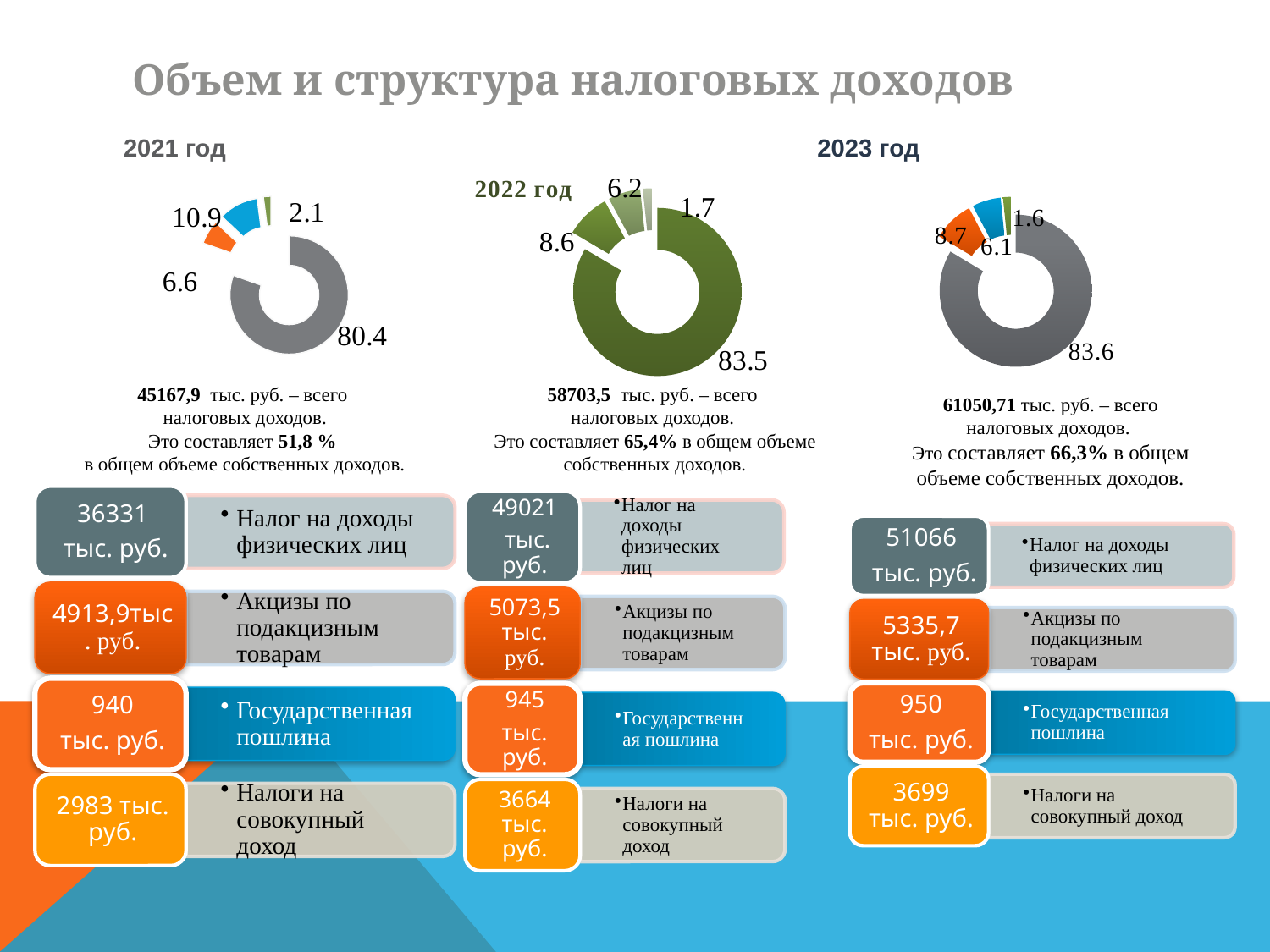
In the 2022 год chart, what is the value of the largest slice? 83.5 In the 2022 год chart, what is the value of the smallest slice? 1.7 In the 2023 год chart, what is the value of the largest slice? 83.6 What is the difference between the largest slice in the 2023 год chart (83.6) and the largest slice in the 2021 год chart (80.4)? 3.2 In the 2022 год chart, what is the difference between the slices labelled 8.6 and 6.2? 2.4 How many slices does the 2022 год chart have? 4 What is the title of the slide containing the three doughnut charts? Объем и структура налоговых доходов In the 2023 год chart, what is the value of the smallest slice? 1.6 What type of chart is used for the 2021 год data? doughnut chart Which is larger: the largest slice in the 2022 год chart or the largest slice in the 2021 год chart? 2022 год (83.5) In the 2021 год chart, what is the value of the smallest slice? 2.1 In the 2021 год chart, what is the value of the largest slice? 80.4